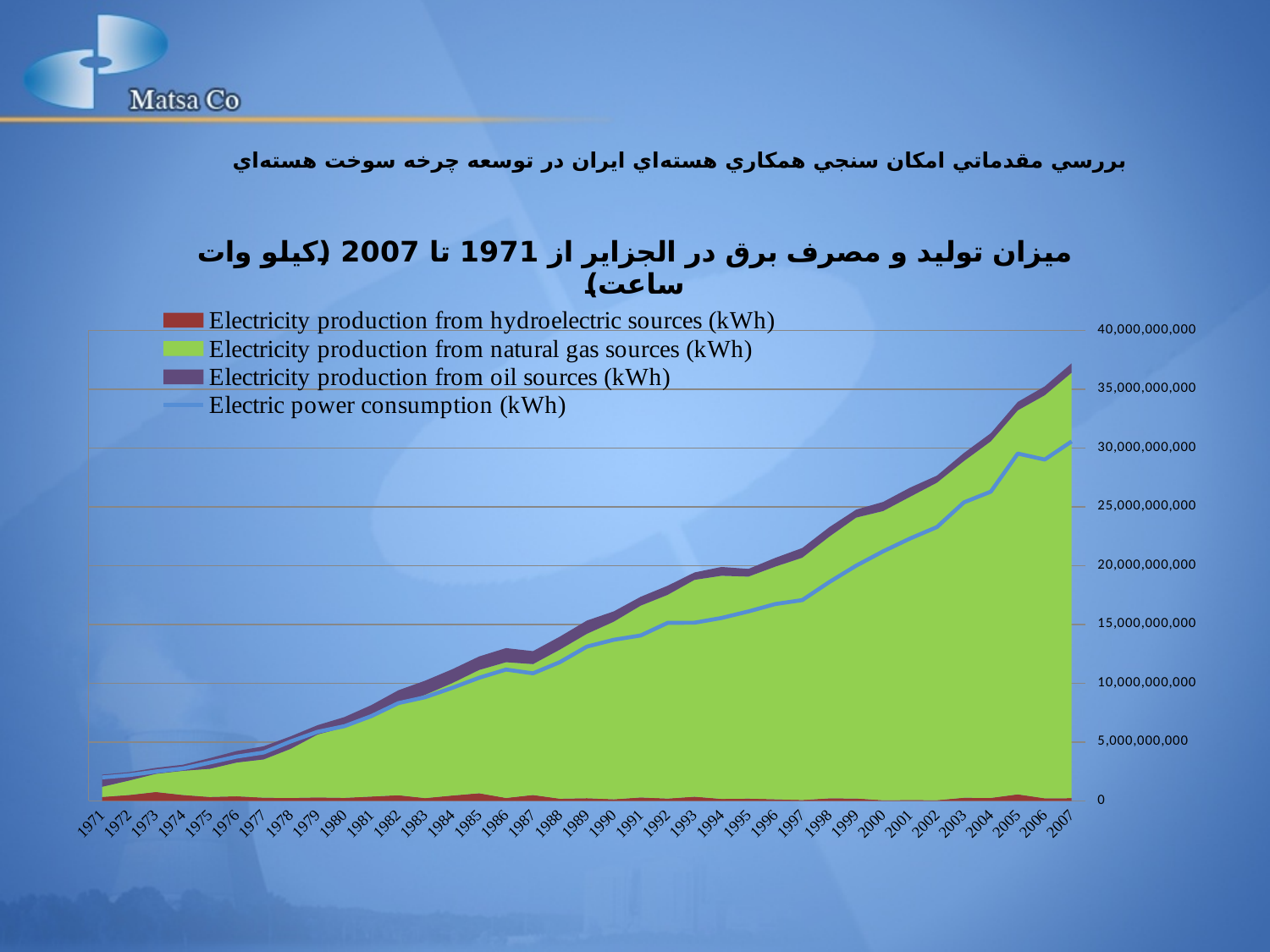
Do the values for Electric power consumption (kWh) rise or fall from 1971 to 2007? Rise How many years are shown along the x axis? 37 Is the value for Electric power consumption (kWh) in 2007 greater or less than 25,000,000,000? greater In which year is Electric power consumption (kWh) highest? 2007 How many series does the legend list? 4 What is the first year shown on the x axis? 1971 Is the value for Electric power consumption (kWh) in 1990 greater or less than 15,000,000,000? less What is the highest value shown on the y axis? 40,000,000,000 Which series contributes the largest share of electricity production in 2007: natural gas sources or hydroelectric sources? Electricity production from natural gas sources (kWh) What is the last year shown on the x axis? 2007 What kind of chart is shown on the slide? Stacked area chart with a line series In which year is Electric power consumption (kWh) lowest? 1971